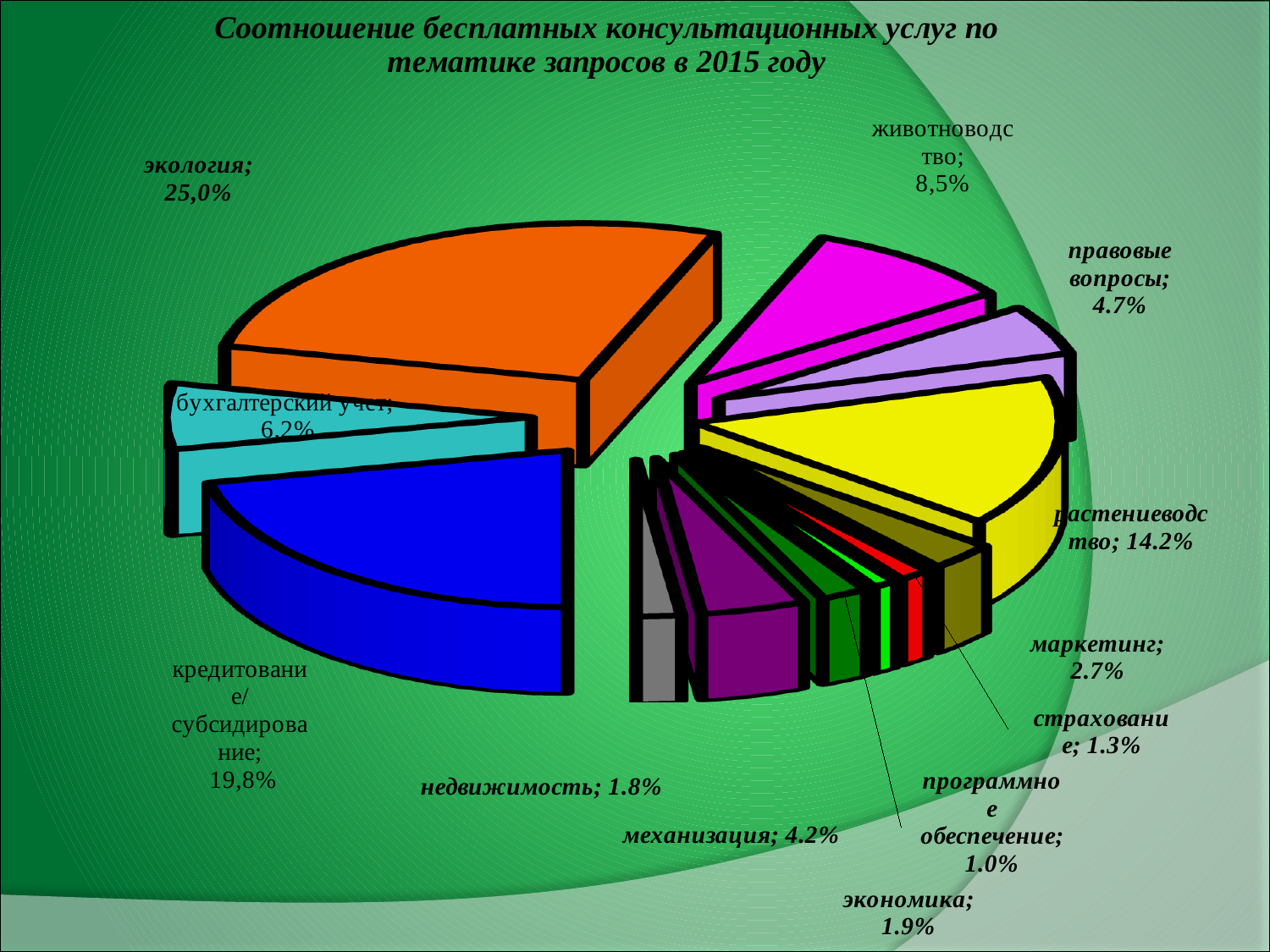
Which category has the smallest share of the pie? программное обеспечение How many categories (slices) are labelled in the pie chart? 12 What is the share for растениеводство? 14.2% Which category has the largest share of the pie? экология What is the share for кредитование/субсидирование? 19,8% What is the share for животноводство? 8,5% What is the share for экология? 25,0% Which is larger, the share for правовые вопросы or the share for маркетинг? правовые вопросы What is the share for механизация? 4.2% What kind of chart is shown on the slide? pie chart What is the difference between the share for экология and the share for кредитование/субсидирование? 5,2% What is the title of the chart? Соотношение бесплатных консультационных услуг по тематике запросов в 2015 году